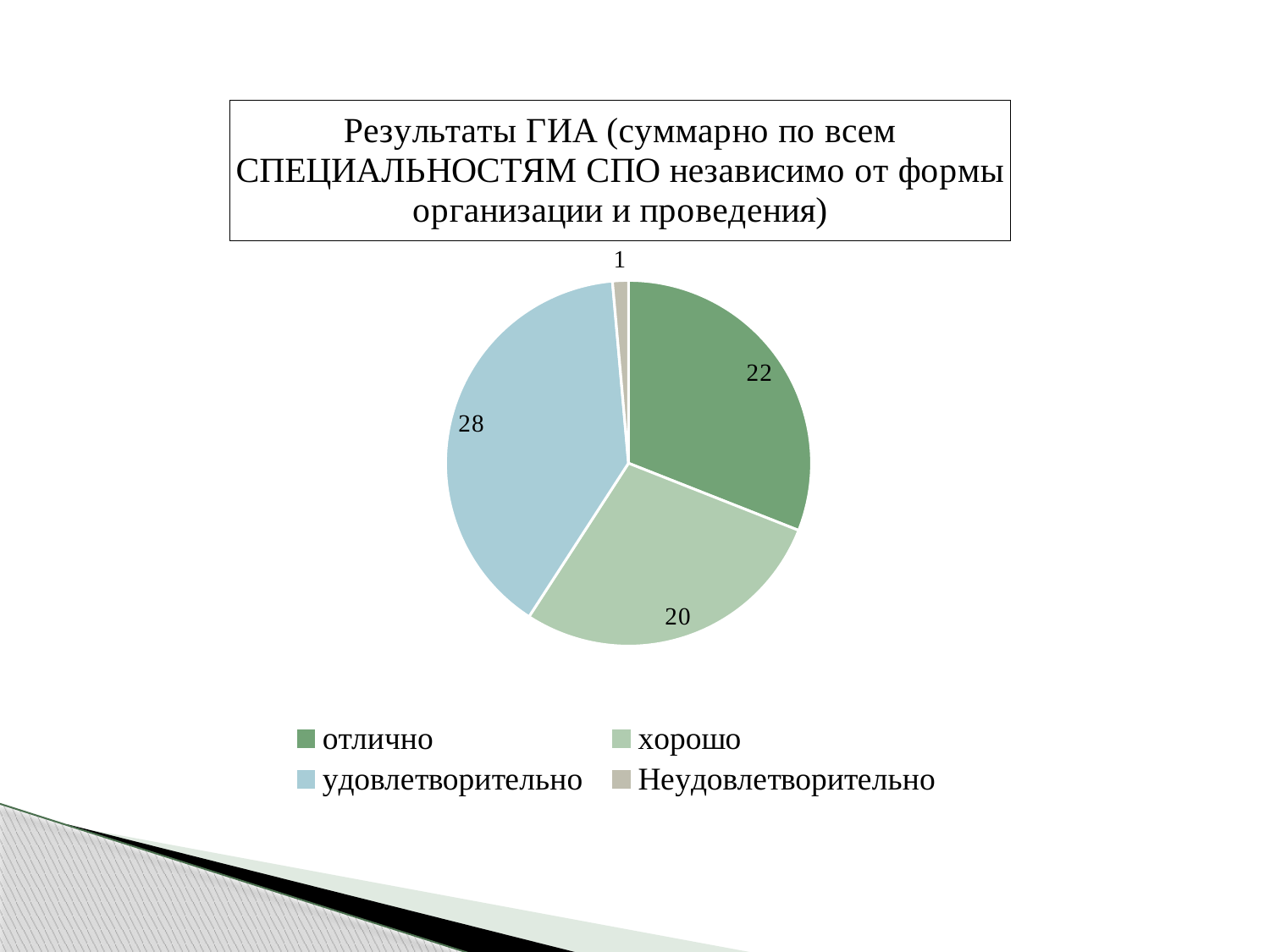
What type of chart is shown on the slide? Pie chart How many slices does the pie chart have? 4 What colour is the 'удовлетворительно' slice in the pie chart? Light blue What is the value for the 'хорошо' slice? 20 What is the value for the 'удовлетворительно' slice? 28 What is the difference between the 'удовлетворительно' and 'отлично' values? 6 What is the value for the 'Неудовлетворительно' slice? 1 Which category has the smallest slice of the pie? Неудовлетворительно Which is larger, the value for 'отлично' or the value for 'хорошо'? отлично Which category has the largest slice of the pie? удовлетворительно What is the value for the 'отлично' slice? 22 What is the total of all the slice values in the pie chart? 71